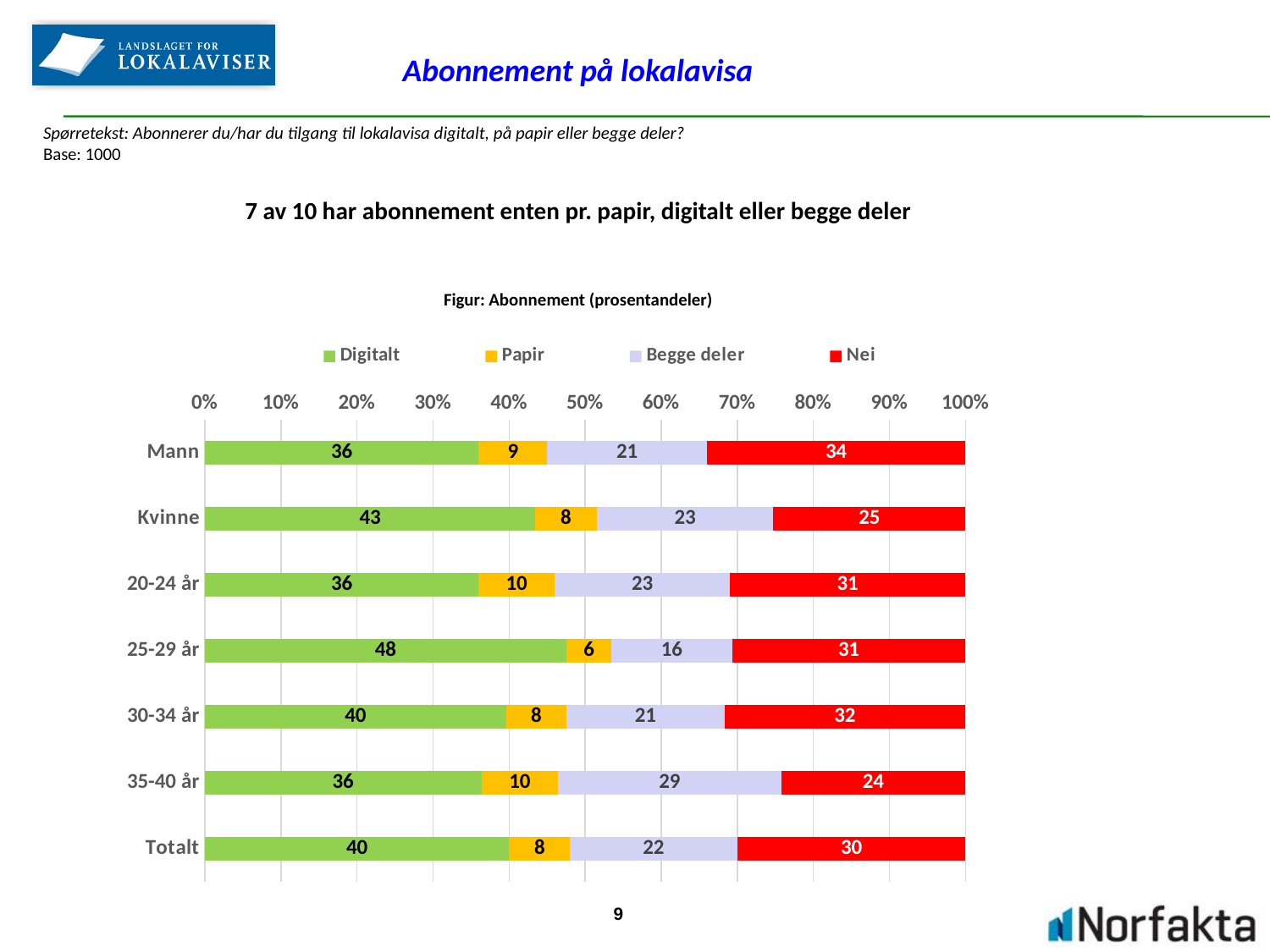
What is the difference between the Nei values for Mann and Kvinne? 9 How many categories are shown on the chart? 7 What is the Papir value for 25-29 år? 6 Which category has the highest Digitalt value? 25-29 år Which category has the lowest Nei value? 35-40 år What kind of chart is shown on the slide? Stacked bar chart What is the Nei value for Mann? 34 What is the Digitalt value for Kvinne? 43 What is the Begge deler value for 35-40 år? 29 Which is larger, the Begge deler value for 35-40 år or for 25-29 år? 35-40 år What is the title of the figure on the slide? Figur: Abonnement (prosentandeler) How many series does the legend list? 4